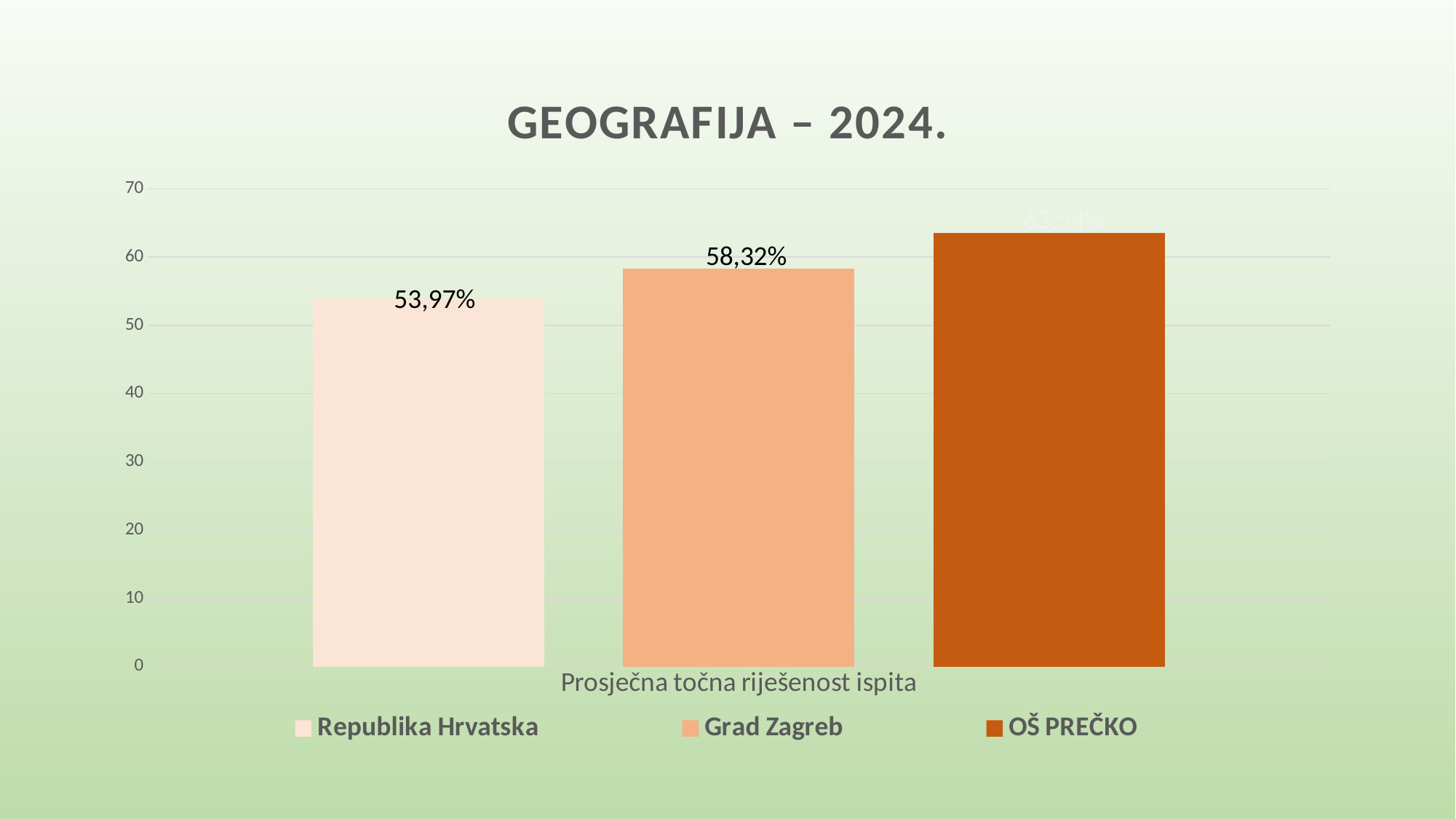
Which is larger, the value for Grad Zagreb or the value for Republika Hrvatska? Grad Zagreb Is the value for OŠ PREČKO greater or less than 60? greater What kind of chart is shown on the slide? bar chart What is the value for Republika Hrvatska? 53,97% How many series does the legend list? 3 What is the title of the chart? GEOGRAFIJA – 2024. Which series has the lowest value? Republika Hrvatska What is the value for Grad Zagreb? 58,32% What is the difference between the values for OŠ PREČKO and Grad Zagreb? 5,22% Which series has the highest value? OŠ PREČKO What is the value for OŠ PREČKO? 63,54% What is the difference between the values for Grad Zagreb and Republika Hrvatska? 4,35%